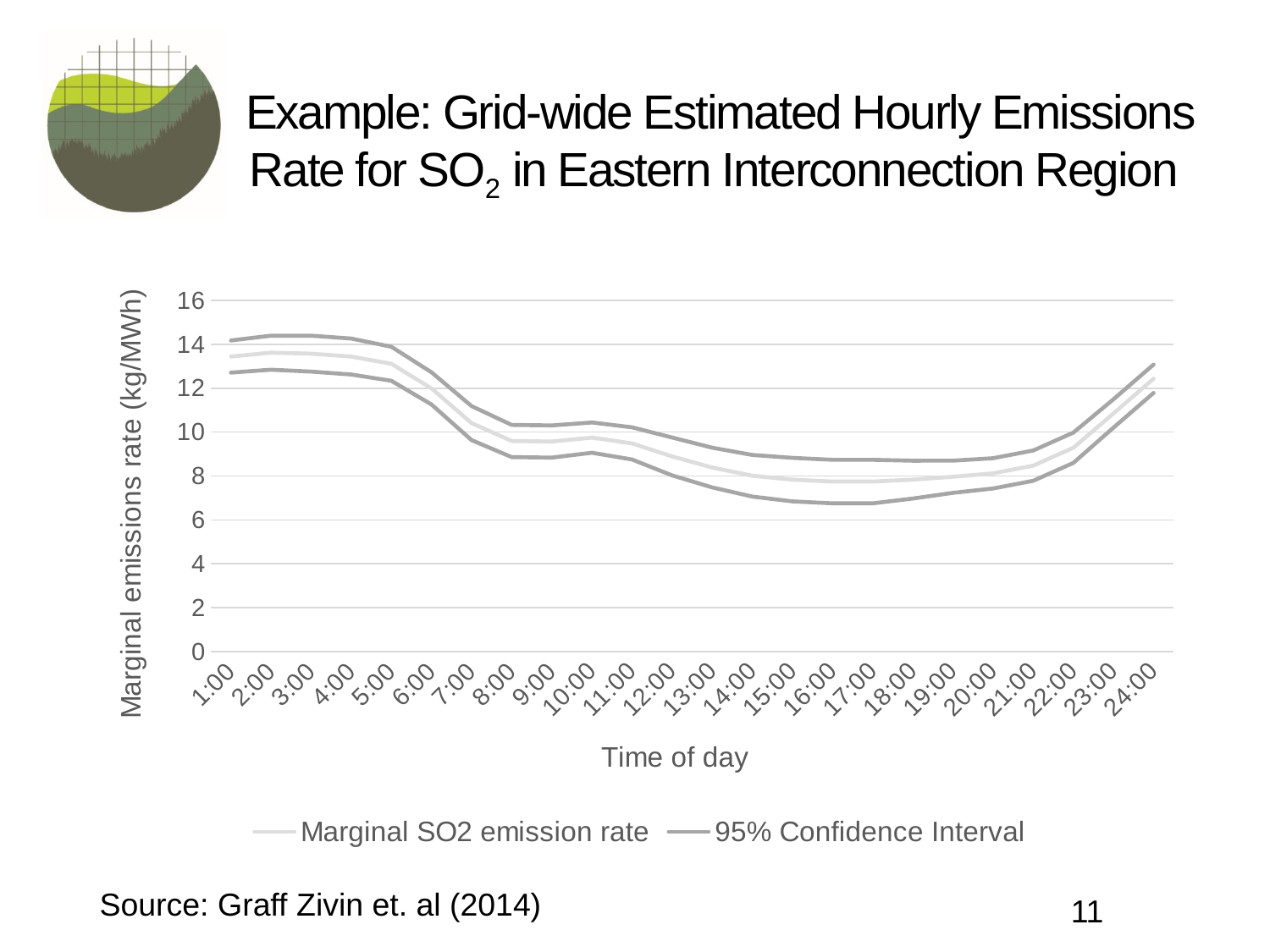
Is the Marginal SO2 emission rate at 1:00 greater or less than 12? greater Is the lower 95% Confidence Interval line at 17:00 greater or less than 8? less Does the Marginal SO2 emission rate rise or fall between 3:00 and 8:00? fall What is the label of the y axis? Marginal emissions rate (kg/MWh) Is the Marginal SO2 emission rate higher at 12:00 or at 24:00? 24:00 Is the Marginal SO2 emission rate higher at 1:00 or at 16:00? 1:00 Is the Marginal SO2 emission rate at 16:00 greater or less than 10? less Does the Marginal SO2 emission rate rise or fall between 17:00 and 24:00? rise How many series does the legend list? 2 What kind of chart is shown on the slide? line chart How many time-of-day points are plotted along the x axis? 24